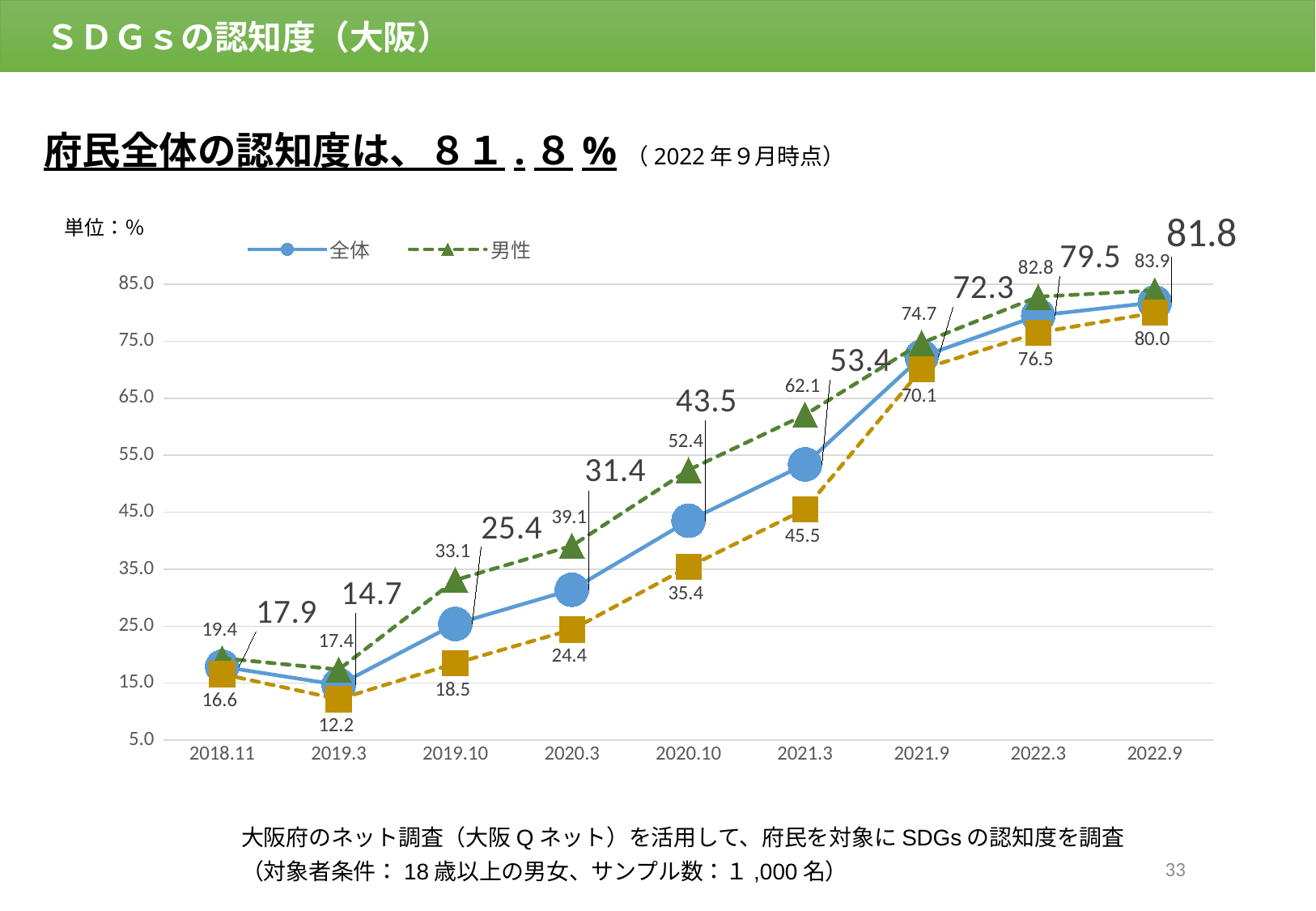
What is the difference between the 男性 and 全体 values at 2022.9? 2.1 At which date is the 男性 value highest? 2022.9 What is the value for 男性 at 2021.3? 62.1 At 2020.10, which is larger: the 全体 value or the 男性 value? 男性 What is the value for 全体 at 2019.3? 14.7 What is the value for 全体 at 2022.9? 81.8 What is the value of the orange square series at 2019.3? 12.2 By how much did the 全体 value increase from 2018.11 to 2022.9? 63.9 What kind of chart is shown? Line chart How many dates are plotted on the x axis? 9 Does the 全体 series rise or fall from 2019.3 to 2022.9? Rise At which date is the 全体 value lowest? 2019.3